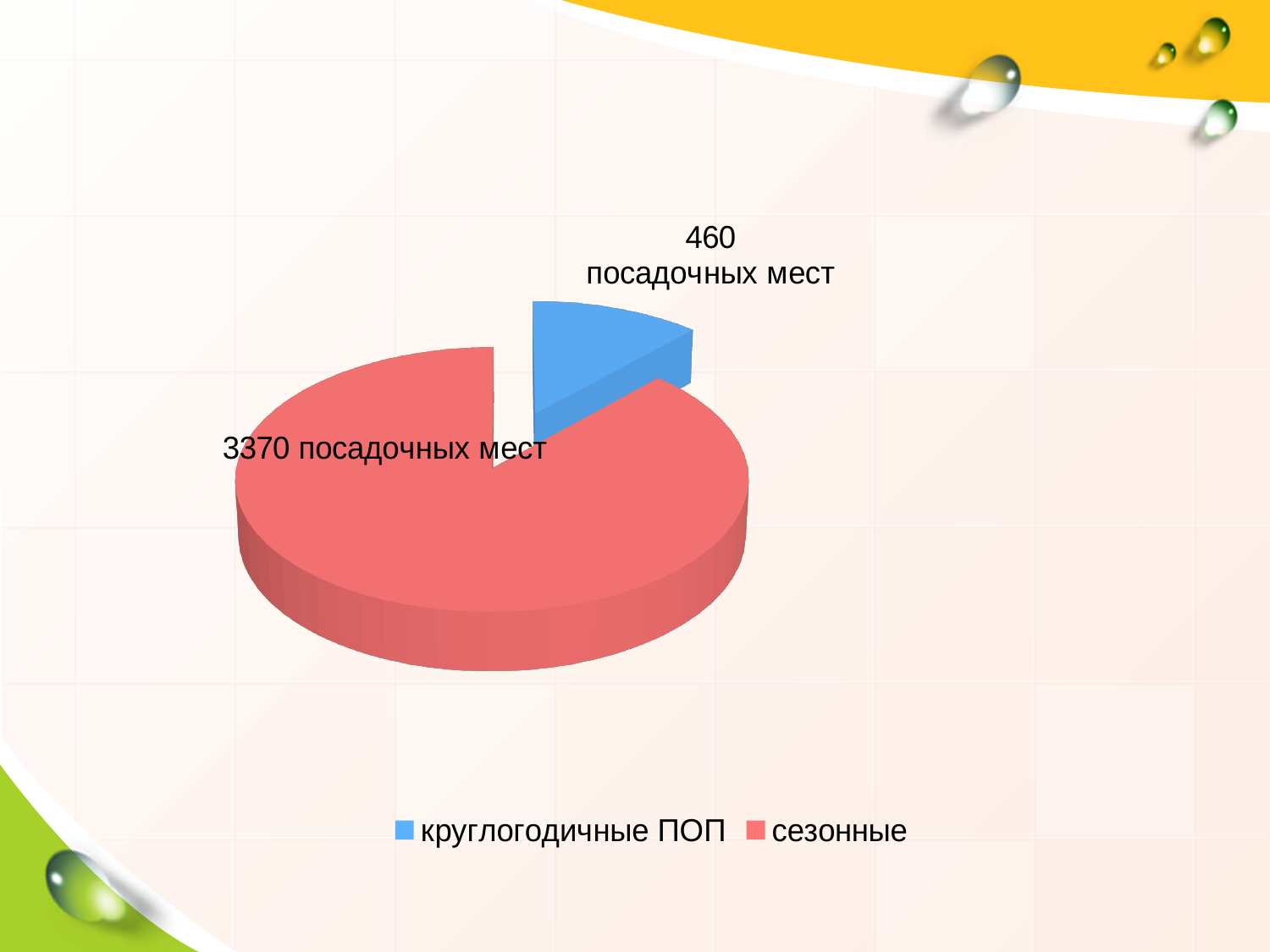
What is the total number of seats across both slices of the pie? 3830 How many seats (посадочных мест) are shown for круглогодичные ПОП? 460 посадочных мест How many seats (посадочных мест) are shown for сезонные? 3370 посадочных мест Which category has the smaller slice of the pie? круглогодичные ПОП What colour is the slice for сезонные? red How many entries does the legend list? 2 Which is larger: the number of seats for круглогодичные ПОП or for сезонные? сезонные How many slices does the pie chart have? 2 What is the difference in seats between сезонные and круглогодичные ПОП? 2910 Which category has the larger slice of the pie? сезонные What kind of chart is shown on the slide? pie chart